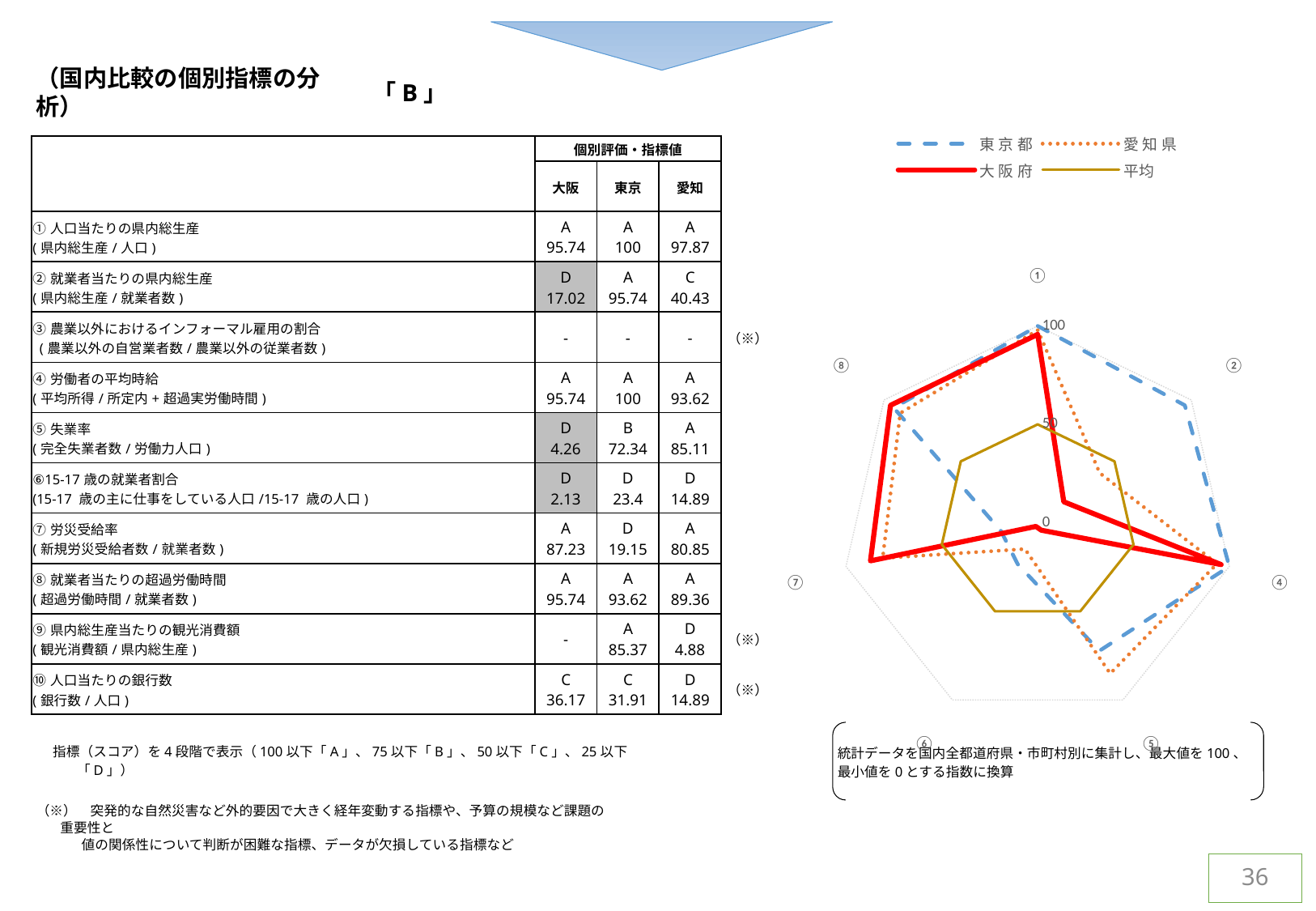
How many numbered axes does the radar chart have? 7 In the radar chart, is the value for 大阪府 on axis ⑤ greater or less than 50? less In the radar chart, is the value for 東京都 on axis ② greater or less than 50? greater What kind of chart is shown on the right side of the slide? radar chart How many series does the legend of the radar chart list? 4 In the radar chart, which series has the larger value on axis ⑤, 愛知県 or 大阪府? 愛知県 In the radar chart, which series is drawn with a thick solid red line? 大阪府 In the radar chart, which series has the larger value on axis ②, 東京都 or 大阪府? 東京都 What is the highest tick value shown on the radar chart's axis? 100 In the radar chart, is the value for 東京都 on axis ⑦ greater or less than 50? less